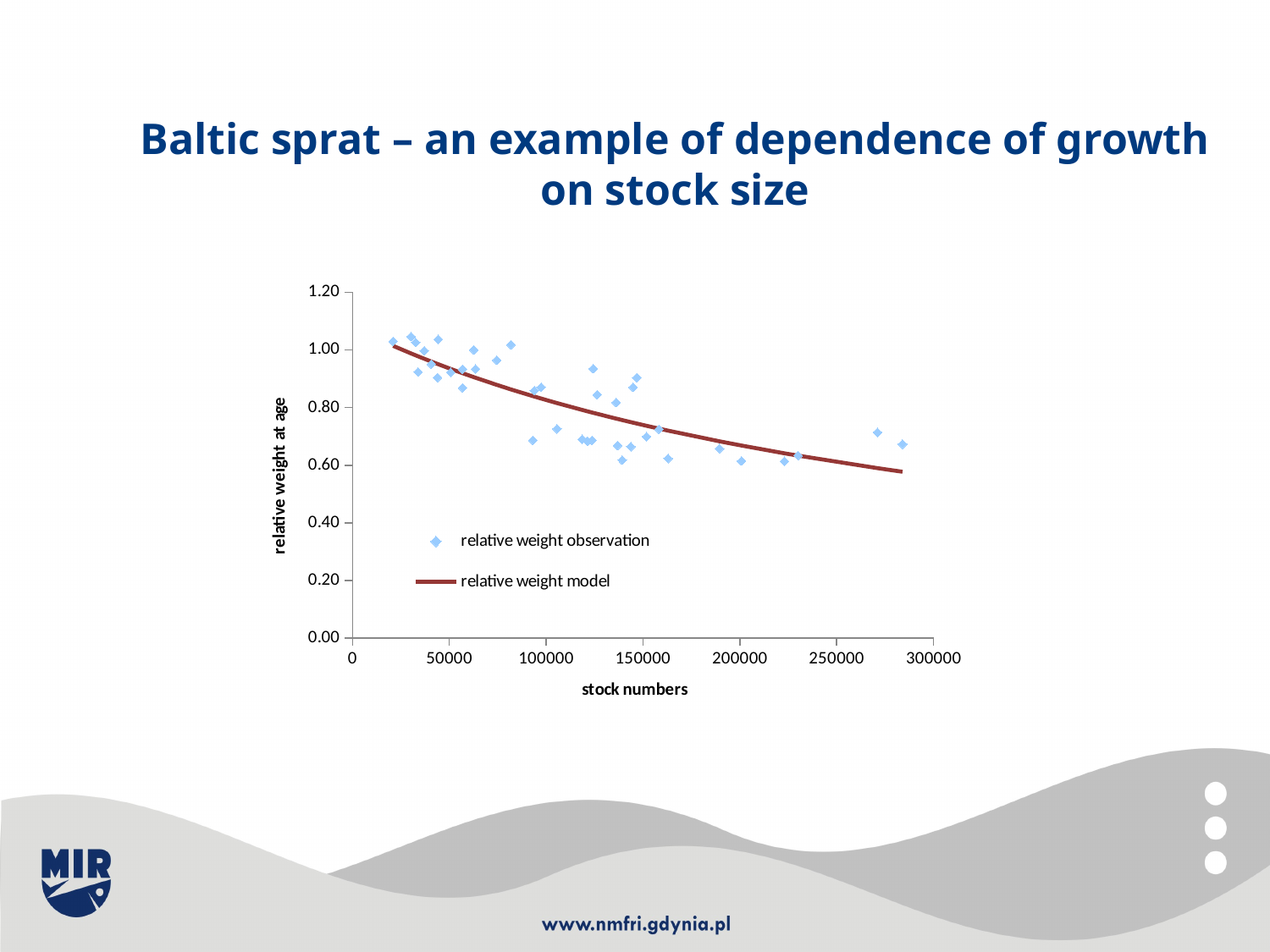
What kind of chart is shown on the slide? scatter chart Are the relative weight observations at stock numbers below 50000 greater or less than 0.80? greater What is the highest value shown on the y axis of the chart? 1.20 How many series does the chart legend list? 2 Is the relative weight model value at stock numbers of 250000 greater or less than 0.80? less Is the relative weight model value at stock numbers of 50000 greater or less than 0.80? greater What are the two series named in the chart legend? relative weight observation; relative weight model What is the label of the x axis of the chart? stock numbers Does the relative weight model line rise or fall as stock numbers increase? fall